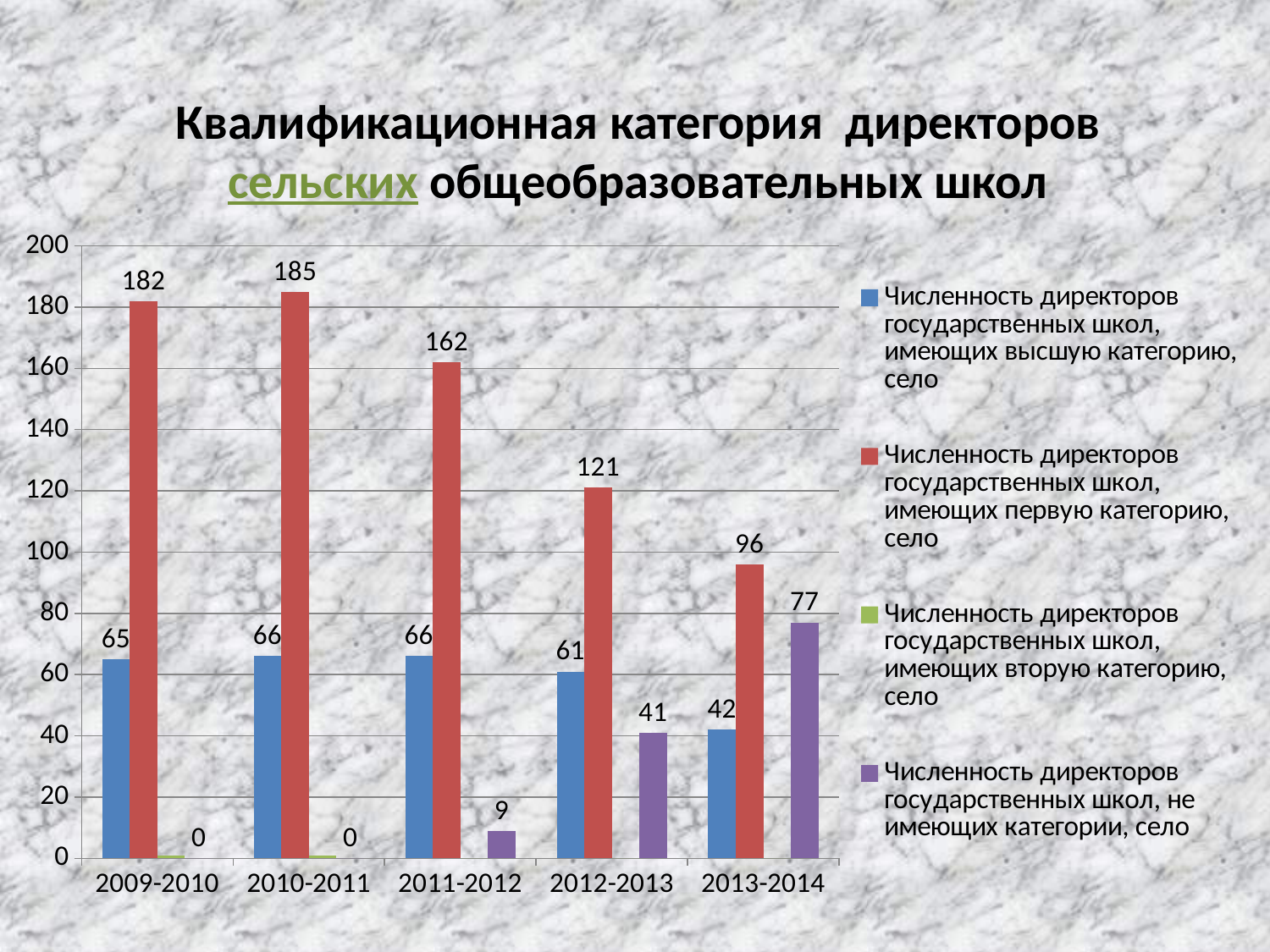
In which school year is the number of directors with the highest category (высшую категорию) the lowest? 2013-2014 How many school-year categories are shown on the x axis? 5 Which is larger in 2013-2014: the number of directors with the first category or the number without a category? the number with the first category (96) What is the difference between the number of directors with the first category in 2009-2010 and in 2013-2014? 86 Which word in the chart title is underlined and shown in green? сельских What type of chart is shown on the slide? bar chart What is the number of rural school directors with the first category (первую категорию) in 2010-2011? 185 In which school year is the number of directors with the first category (первую категорию) the highest? 2010-2011 How does the number of directors with the first category (первую категорию) change from 2010-2011 to 2013-2014? it falls How many series does the legend list? 4 What is the number of rural school directors without a category (не имеющих категории) in 2012-2013? 41 What is the number of rural school directors with the highest category (высшую категорию) in 2013-2014? 42